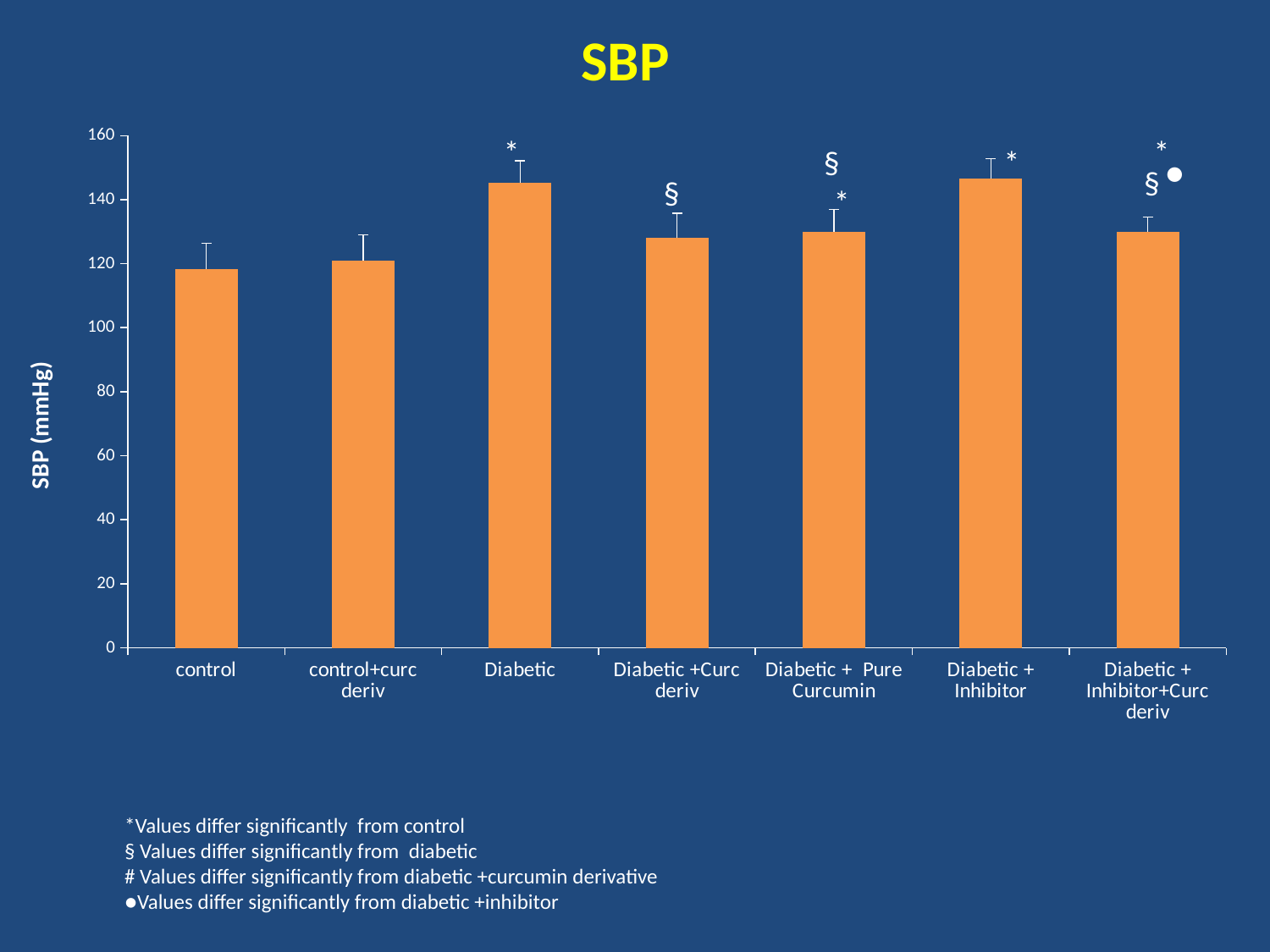
Is the value for Diabetic + Pure Curcumin greater or less than 140? less How many categories (bars) are shown in the chart? 7 Is the value for control greater or less than 100? greater Is the value for Diabetic + Inhibitor greater or less than 140? greater What kind of chart is shown on the slide? bar chart Which is larger, the value for Diabetic or the value for Diabetic +Curc deriv? Diabetic What is the title of the chart? SBP What is the label on the vertical axis of the chart? SBP (mmHg) Which is larger, the value for Diabetic or the value for control? Diabetic Which is larger, the value for Diabetic + Inhibitor or the value for Diabetic + Inhibitor+Curc deriv? Diabetic + Inhibitor